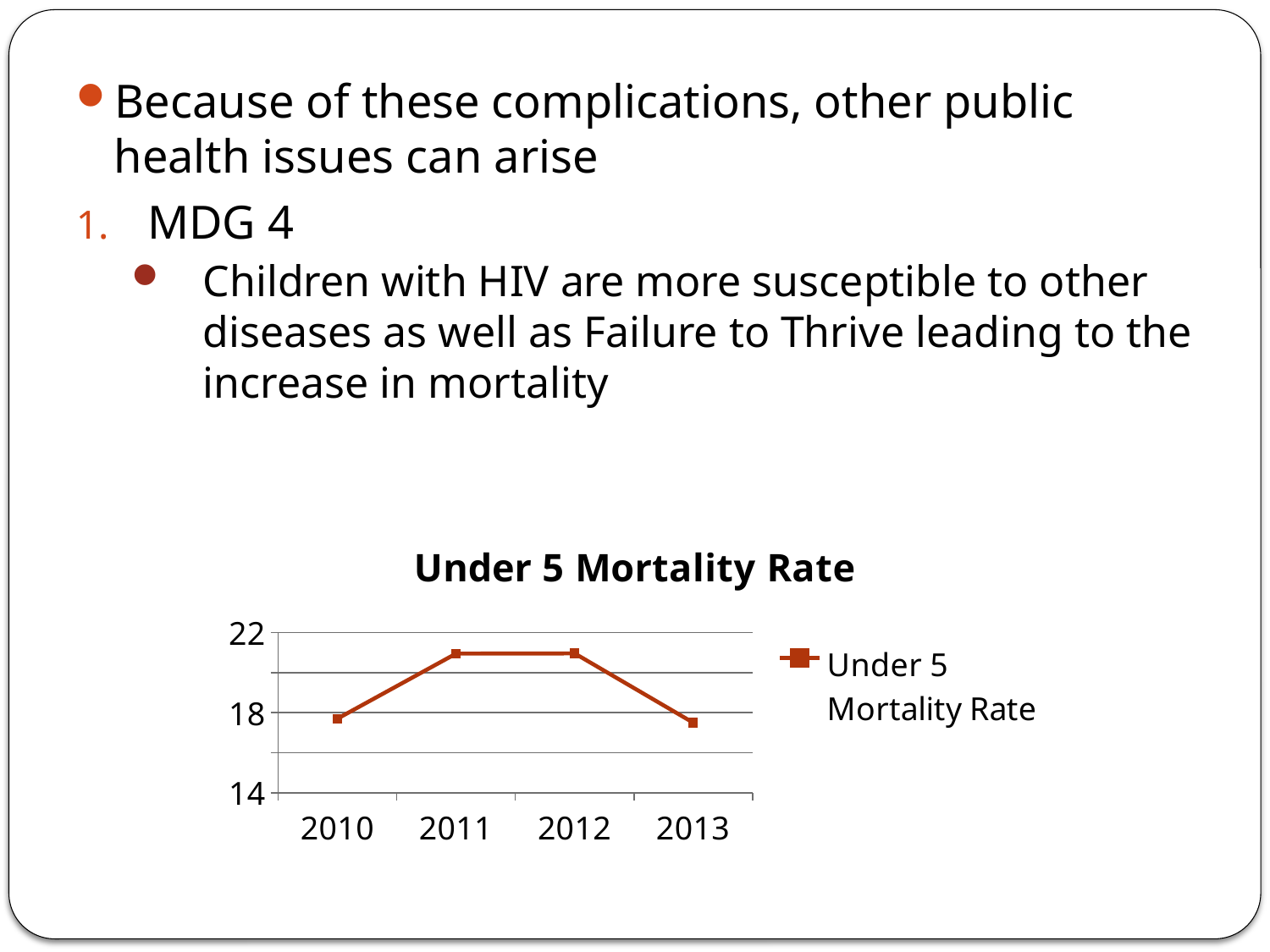
How many years are plotted on the x axis of the chart? 4 Does the Under 5 Mortality Rate rise or fall from 2012 to 2013? fall What is the title of the chart? Under 5 Mortality Rate Which year has the larger value, 2010 or 2011? 2011 Which year has the larger value, 2012 or 2013? 2012 Is the value for 2010 greater or less than 22? less Is the value for 2013 greater or less than 22? less How many series does the chart's legend list? 1 What kind of chart is shown on the slide? line chart Is the value for 2012 greater or less than 18? greater Does the Under 5 Mortality Rate rise or fall from 2010 to 2011? rise